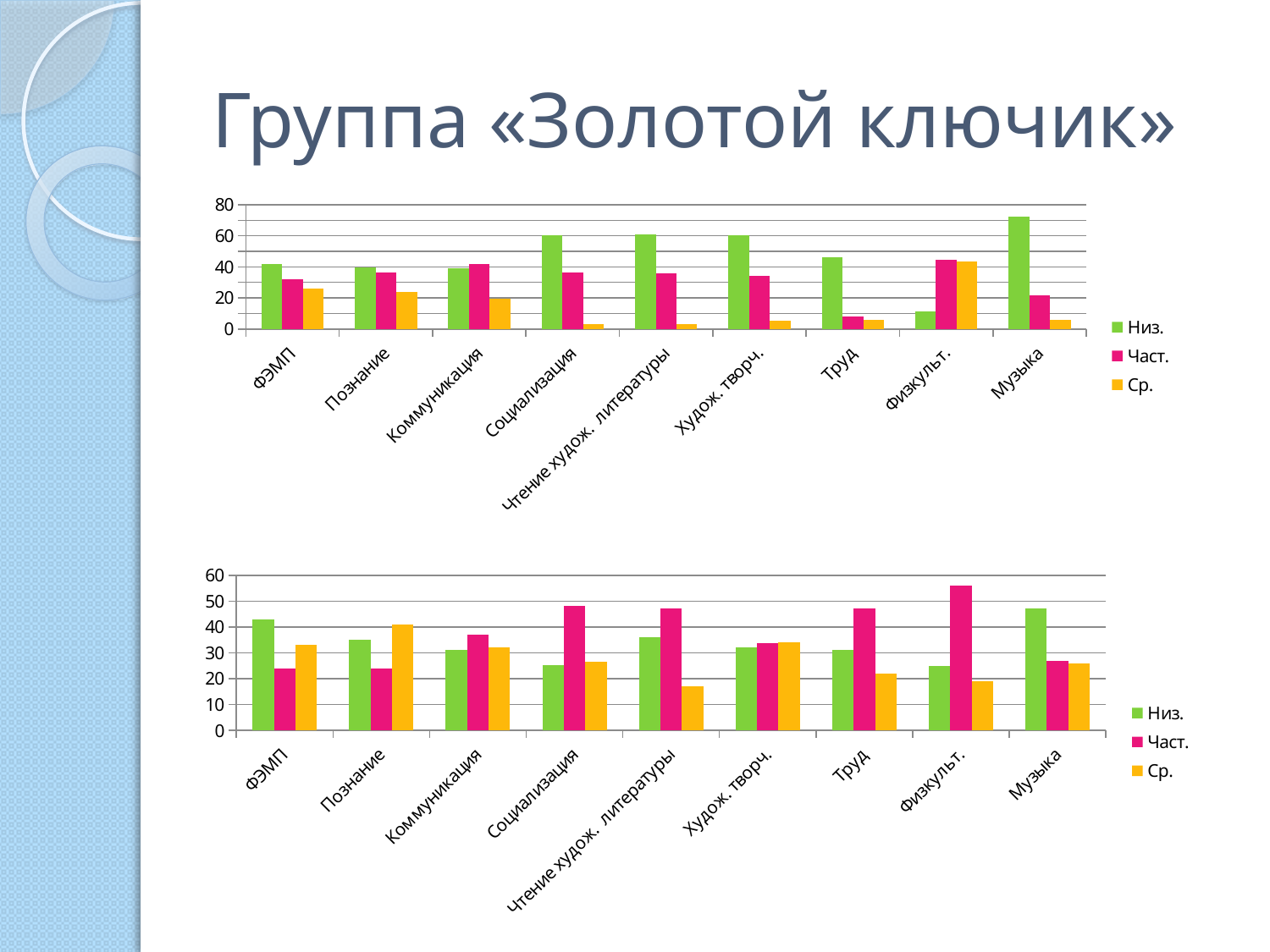
In the bottom chart, which category has the highest value for the Част. series? Физкульт. In the top chart, which category has the highest value for the Низ. series? Музыка In the bottom chart, is the Част. value for Физкульт. greater or less than 50? greater In the bottom chart, for Социализация, which series has the larger value: Низ. or Част.? Част. What kind of chart is the top chart on the slide? bar chart What are the three legend entries of the top chart? Низ., Част., Ср. How many categories are shown on the x axis of the top chart? 9 In the top chart, is the Низ. value for Социализация greater or less than 40? greater How many series does the legend of the bottom chart list? 3 In the top chart, which category has the lowest value for the Низ. series? Физкульт. In the top chart, which category has the highest value for the Ср. series? Физкульт. In the top chart, is the Част. value for Труд greater or less than 20? less